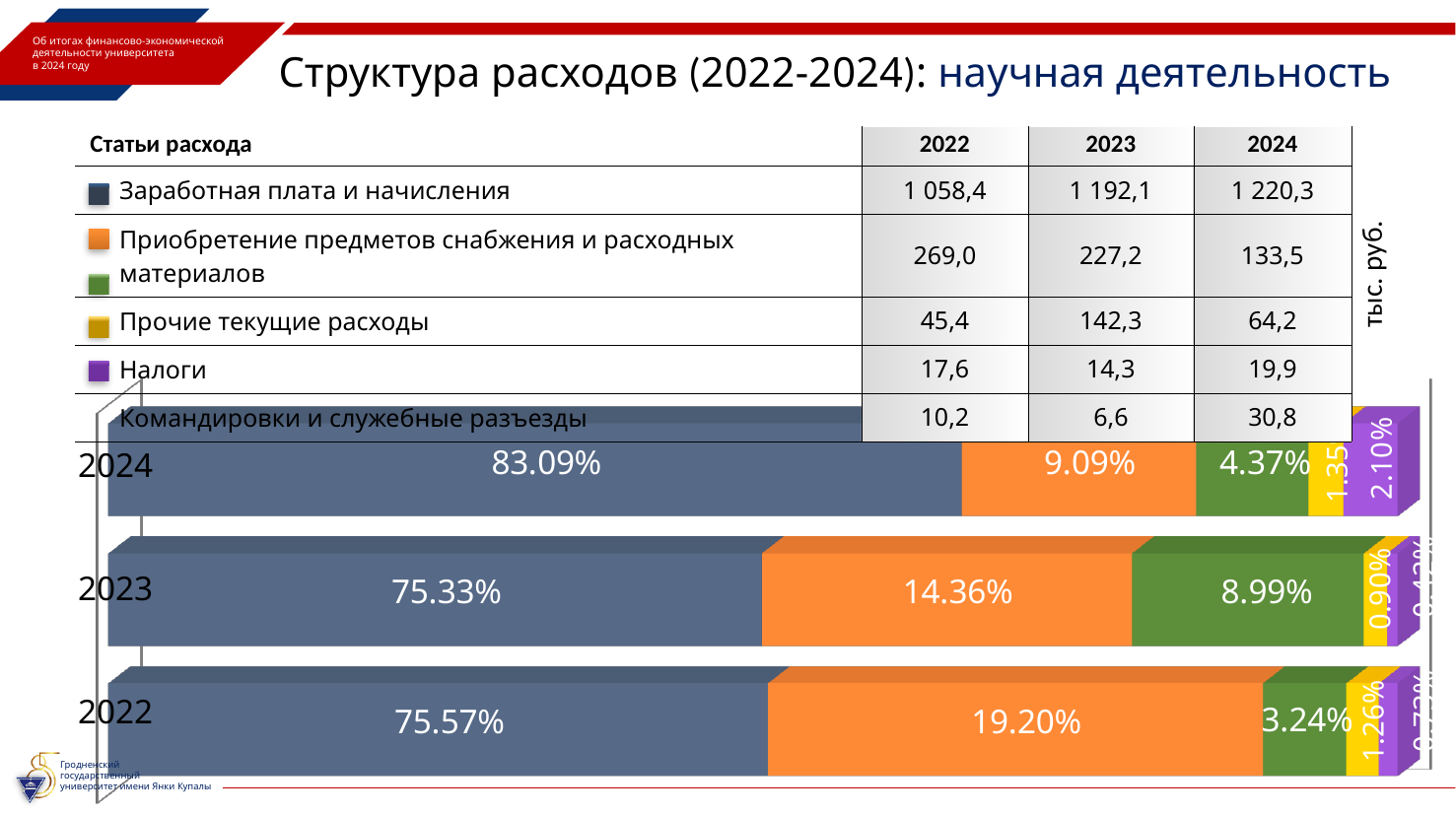
In the stacked bar chart, what is the value of the yellow segment of the 2023 bar? 0.90% In the stacked bar chart, what is the value of the orange segment of the 2023 bar? 14.36% In the stacked bar chart, is the orange segment larger in 2022 or in 2023? 2022 In the stacked bar chart, what is the value of the largest (dark blue) segment of the 2024 bar? 83.09% In the stacked bar chart, does the orange segment's share rise or fall from 2022 to 2024? Fall How many bars (years) does the stacked bar chart show? 3 In the stacked bar chart, which year has the smallest green segment? 2022 In the stacked bar chart, which year has the largest dark blue (first) segment? 2024 In the stacked bar chart, what is the value of the purple segment of the 2024 bar? 2.10% In the stacked bar chart, what is the difference between the dark blue segment in 2024 (83.09%) and in 2023 (75.33%)? 7.76 percentage points In the stacked bar chart, what is the value of the green segment of the 2022 bar? 3.24% What type of chart is shown at the bottom of the slide? Stacked bar chart